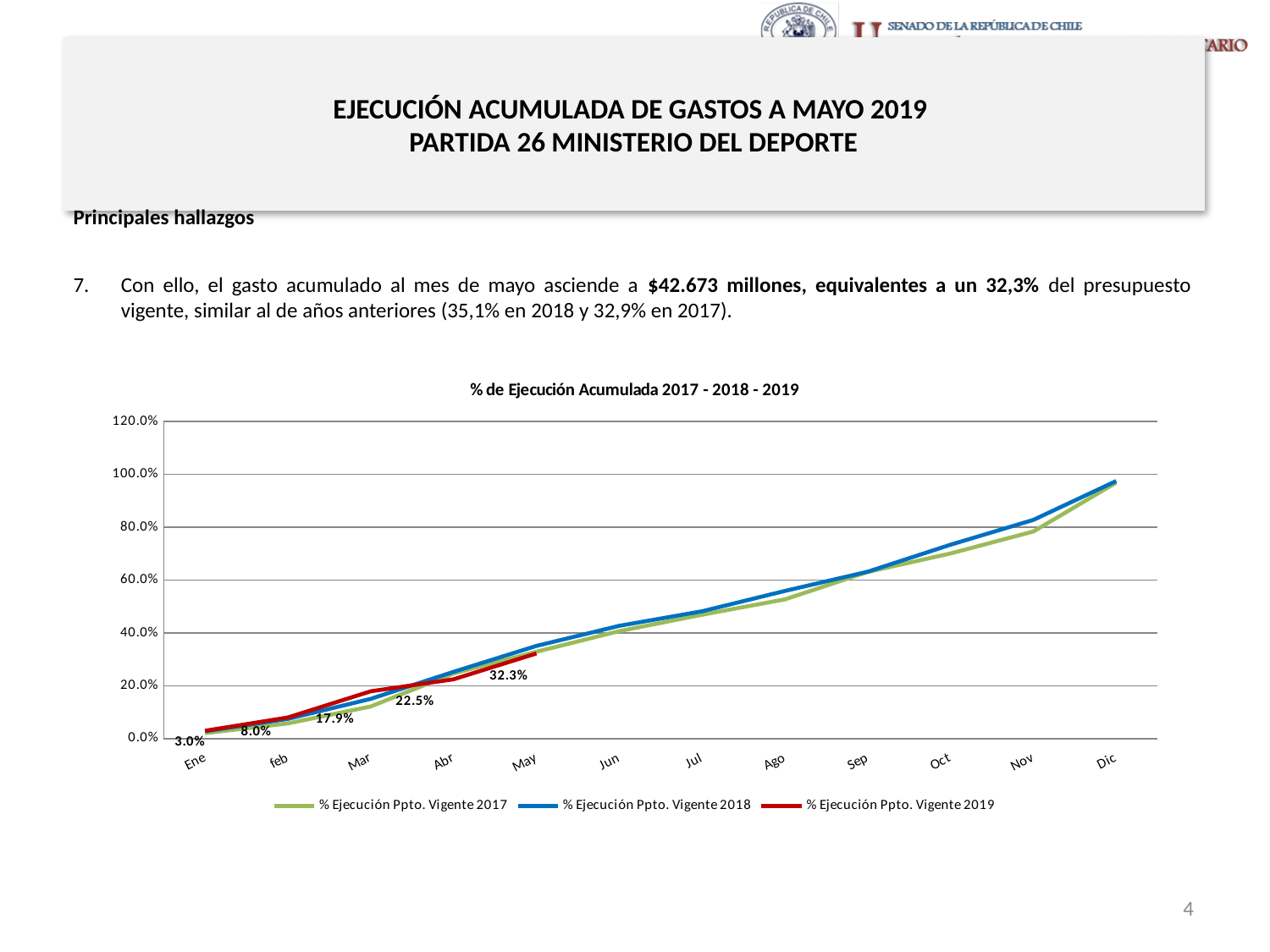
What is the difference between the 2019 values for May and Abr? 9.8% What is the value of % Ejecución Ppto. Vigente 2019 for Mar? 17.9% How many series does the legend list? 3 What is the difference between the 2019 values for feb and Ene? 5.0% What is the title of the chart? % de Ejecución Acumulada 2017 - 2018 - 2019 Is the value for % Ejecución Ppto. Vigente 2017 in Jun greater or less than 60.0%? less What is the value of % Ejecución Ppto. Vigente 2019 for May? 32.3% What is the value of % Ejecución Ppto. Vigente 2019 for Ene? 3.0% What kind of chart is shown on the slide? line chart How many months are shown along the x axis? 12 Is the value for % Ejecución Ppto. Vigente 2018 in Dic greater or less than 80.0%? greater Does the % Ejecución Ppto. Vigente 2019 series rise or fall from Ene to May? rise